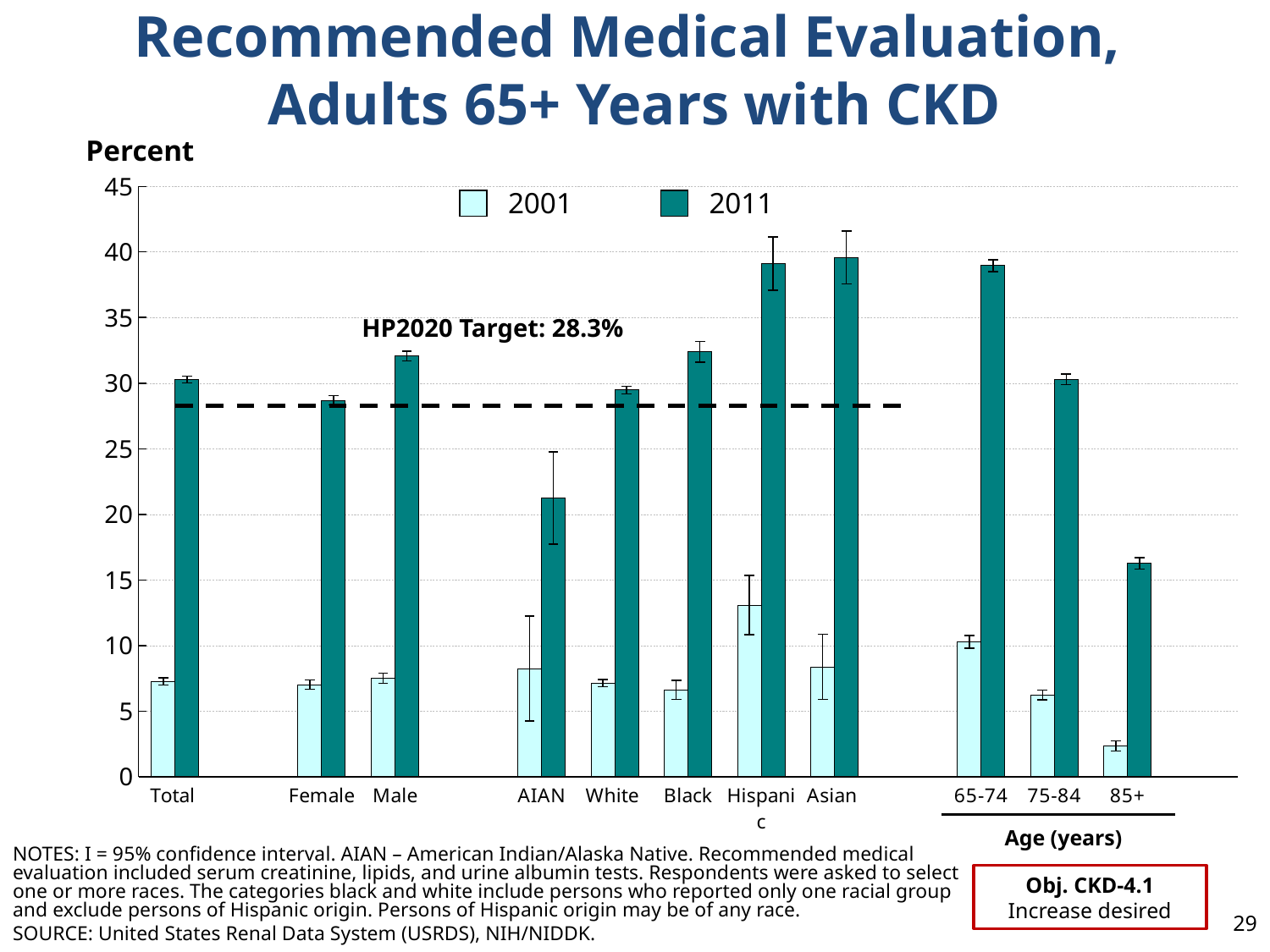
Which category has the lowest value for 2011? 85+ Which is larger for 2011, Female or Male? Male What kind of chart is shown on the slide? Bar chart How many categories are shown along the x axis? 11 Is the 2011 value for Male greater or less than 30? greater Which category has the lowest value for 2001? 85+ What is the HP2020 Target value shown on the chart? 28.3% Is the 2011 value for 85+ greater or less than 20? less Do the 2011 values rise or fall across the age groups from 65-74 to 85+? fall How many series does the legend list? 2 Which category has the highest value for 2001? Hispanic Is the 2011 value for AIAN greater or less than 25? less